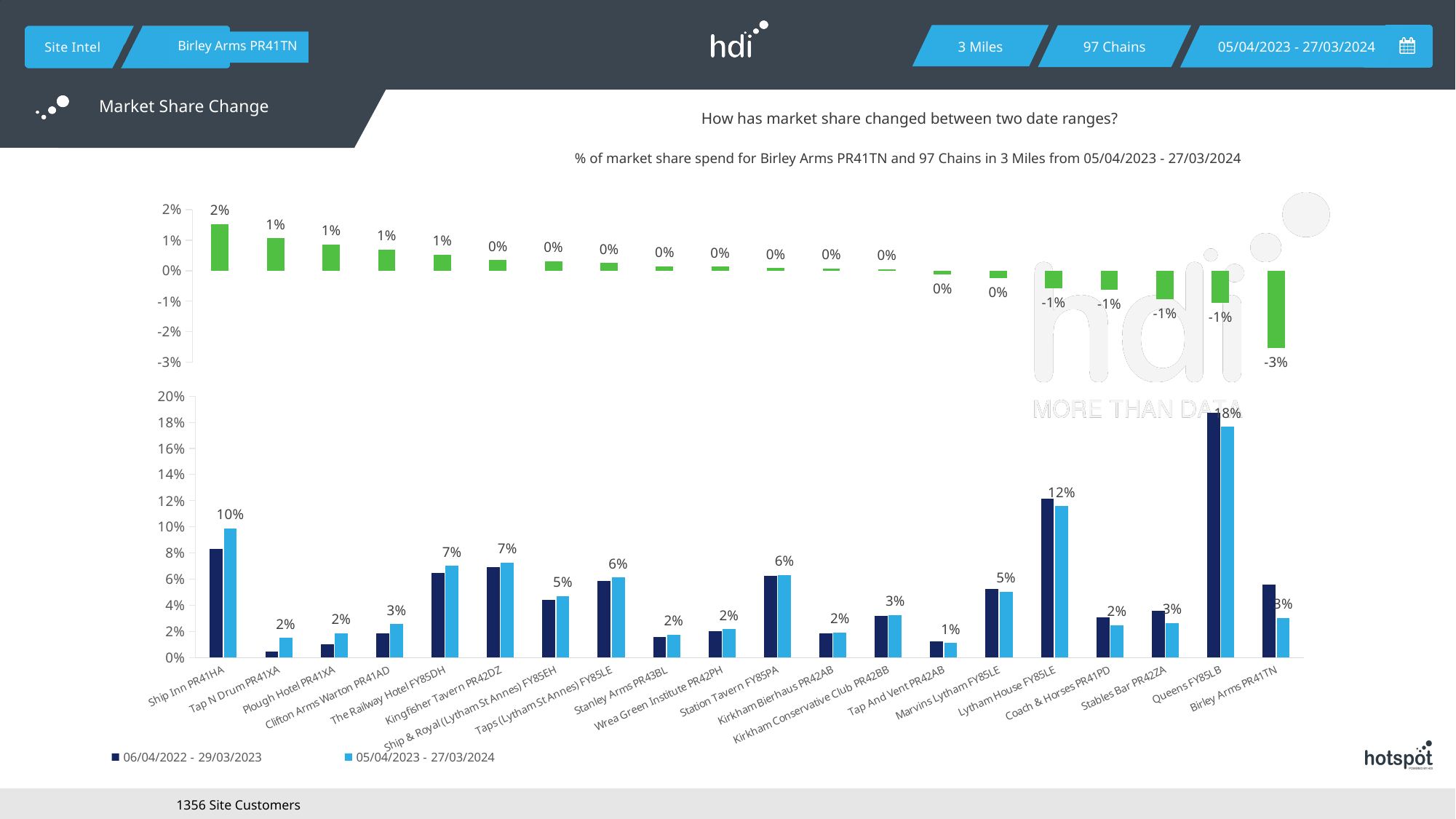
In the lower chart, what is the value for Lytham House FY85LE in the 05/04/2023 - 27/03/2024 series? 12% In the lower chart, which category has the highest value in the 05/04/2023 - 27/03/2024 series? Queens FY85LB How many series does the legend of the lower chart list? 2 What kind of chart is the lower chart on the slide? bar chart How many categories are shown on the x axis of the lower chart? 20 In the upper (green) chart, what is the highest value shown? 2% In the lower chart, is the value for Queens FY85LB in the 06/04/2022 - 29/03/2023 series greater or less than 16%? greater In the lower chart, what is the difference between the 05/04/2023 - 27/03/2024 values for Queens FY85LB and Lytham House FY85LE? 6% In the lower chart, is the value for Ship Inn PR41HA in the 06/04/2022 - 29/03/2023 series greater or less than 10%? less In the lower chart, which has the larger 05/04/2023 - 27/03/2024 value: Ship Inn PR41HA or The Railway Hotel FY85DH? Ship Inn PR41HA In the upper (green) chart, what is the lowest value shown? -3% In the lower chart, what is the value for Queens FY85LB in the 05/04/2023 - 27/03/2024 series? 18%